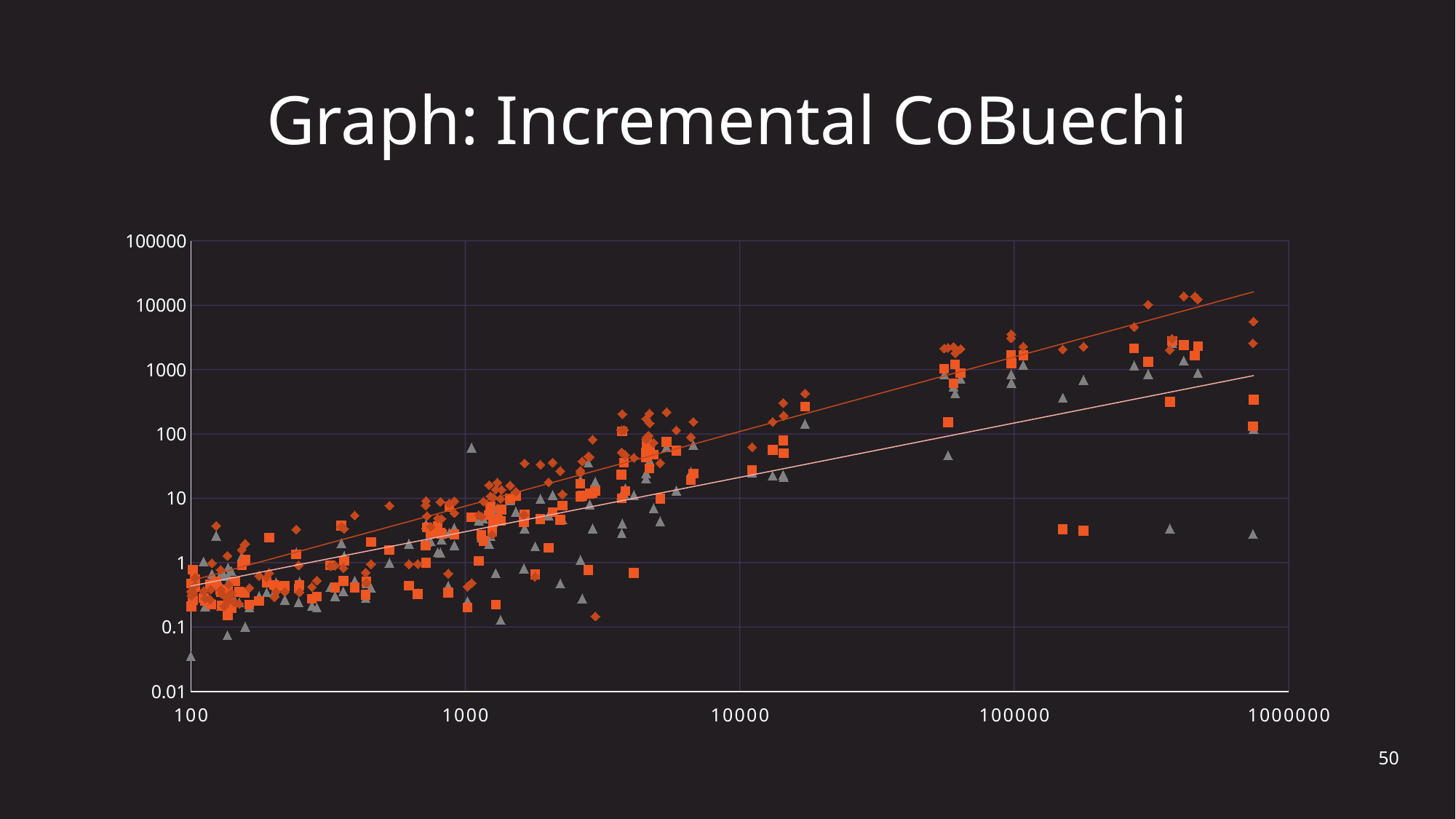
What is the lowest value labelled on the y axis? 0.01 Is the highest plotted point greater or less than 10000 on the y axis? greater What is the title of the chart? Graph: Incremental CoBuechi What kind of chart is shown on the slide? scatter chart What is the highest value labelled on the y axis? 100000 What is the highest value labelled on the x axis? 1000000 How many trend lines are drawn on the chart? 2 Is the lowest plotted point greater or less than 0.1 on the y axis? less What is the lowest value labelled on the x axis? 100 Do the plotted values generally rise or fall as the x-axis values increase? rise